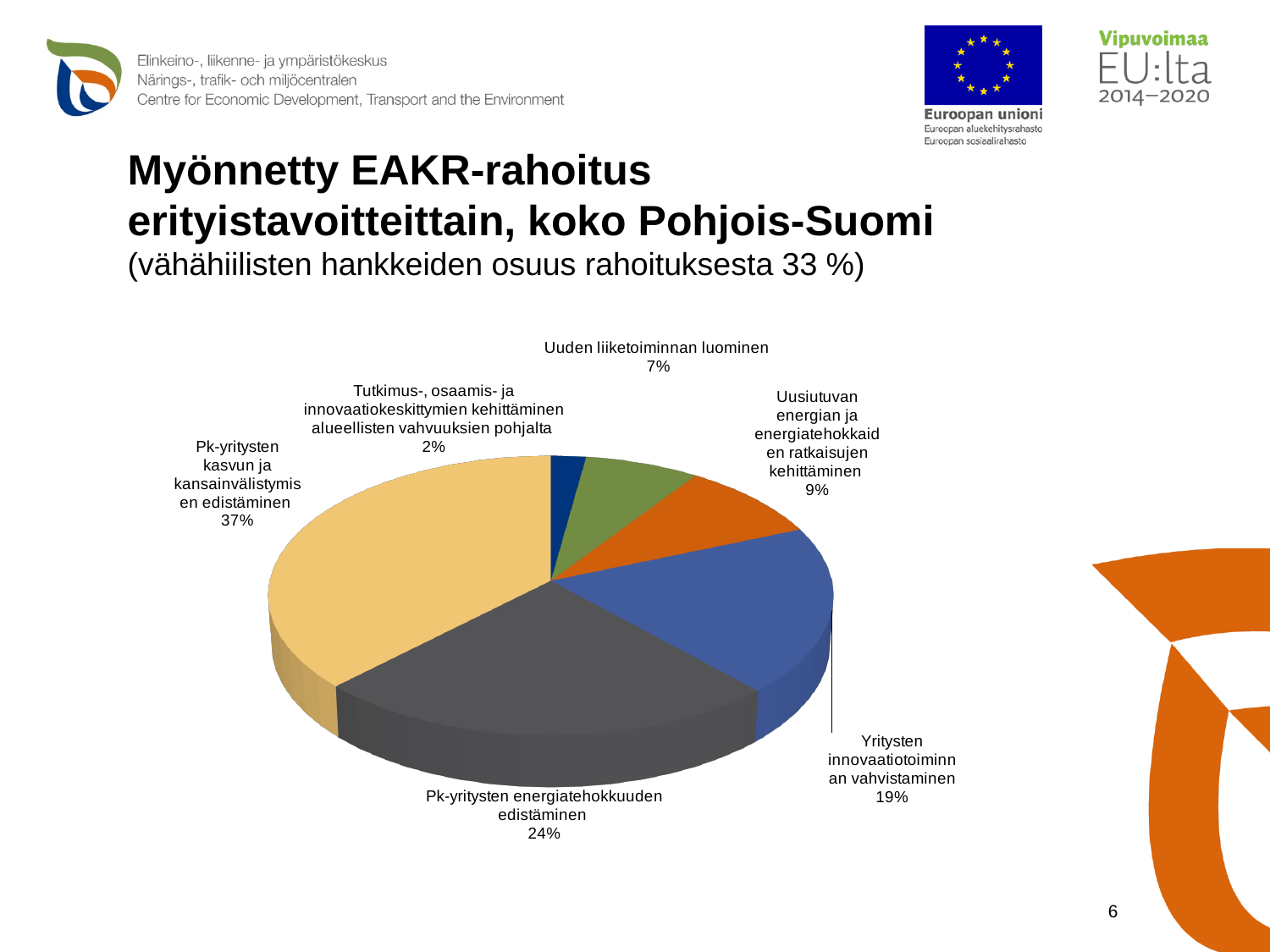
According to the slide subtitle, what share of the funding goes to low-carbon projects (vähähiiliset hankkeet)? 33 % What share of the pie does "Pk-yritysten kasvun ja kansainvälistymisen edistäminen" have? 37% Which category has the largest share of the pie? Pk-yritysten kasvun ja kansainvälistymisen edistäminen How many slices does the pie chart have? 6 What percentage is shown for "Uuden liiketoiminnan luominen"? 7% What is the difference in percentage points between "Pk-yritysten kasvun ja kansainvälistymisen edistäminen" and "Pk-yritysten energiatehokkuuden edistäminen"? 13 percentage points What percentage is shown for "Uusiutuvan energian ja energiatehokkaiden ratkaisujen kehittäminen"? 9% Which category has the smallest share of the pie? Tutkimus-, osaamis- ja innovaatiokeskittymien kehittäminen alueellisten vahvuuksien pohjalta What type of chart is shown on the slide? Pie chart What percentage is shown for "Yritysten innovaatiotoiminnan vahvistaminen"? 19% What percentage is shown for "Pk-yritysten energiatehokkuuden edistäminen"? 24% Which is larger: the share for "Yritysten innovaatiotoiminnan vahvistaminen" or for "Uusiutuvan energian ja energiatehokkaiden ratkaisujen kehittäminen"? Yritysten innovaatiotoiminnan vahvistaminen